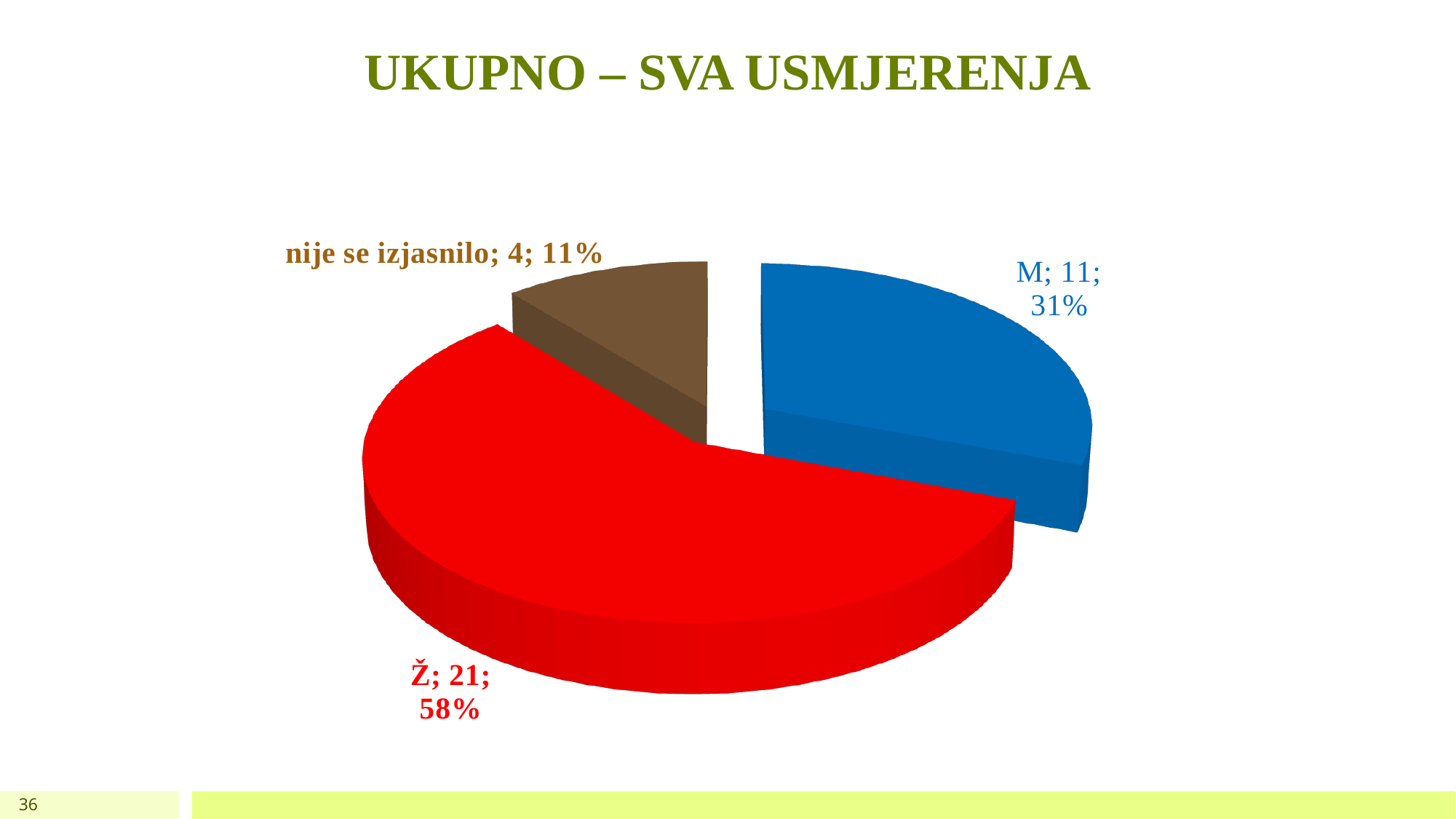
What share of the pie does the Ž slice represent? 58% Which is larger, the value for M or the value for 'nije se izjasnilo'? M What is the value for 'nije se izjasnilo'? 4 What is the value for M? 11 What kind of chart is shown on the slide? pie chart Which category has the smallest slice? nije se izjasnilo What share of the pie does the M slice represent? 31% How many slices does the pie chart have? 3 What is the difference between the values for Ž and M? 10 Which category has the largest slice? Ž What is the value for Ž? 21 What share of the pie does the 'nije se izjasnilo' slice represent? 11%